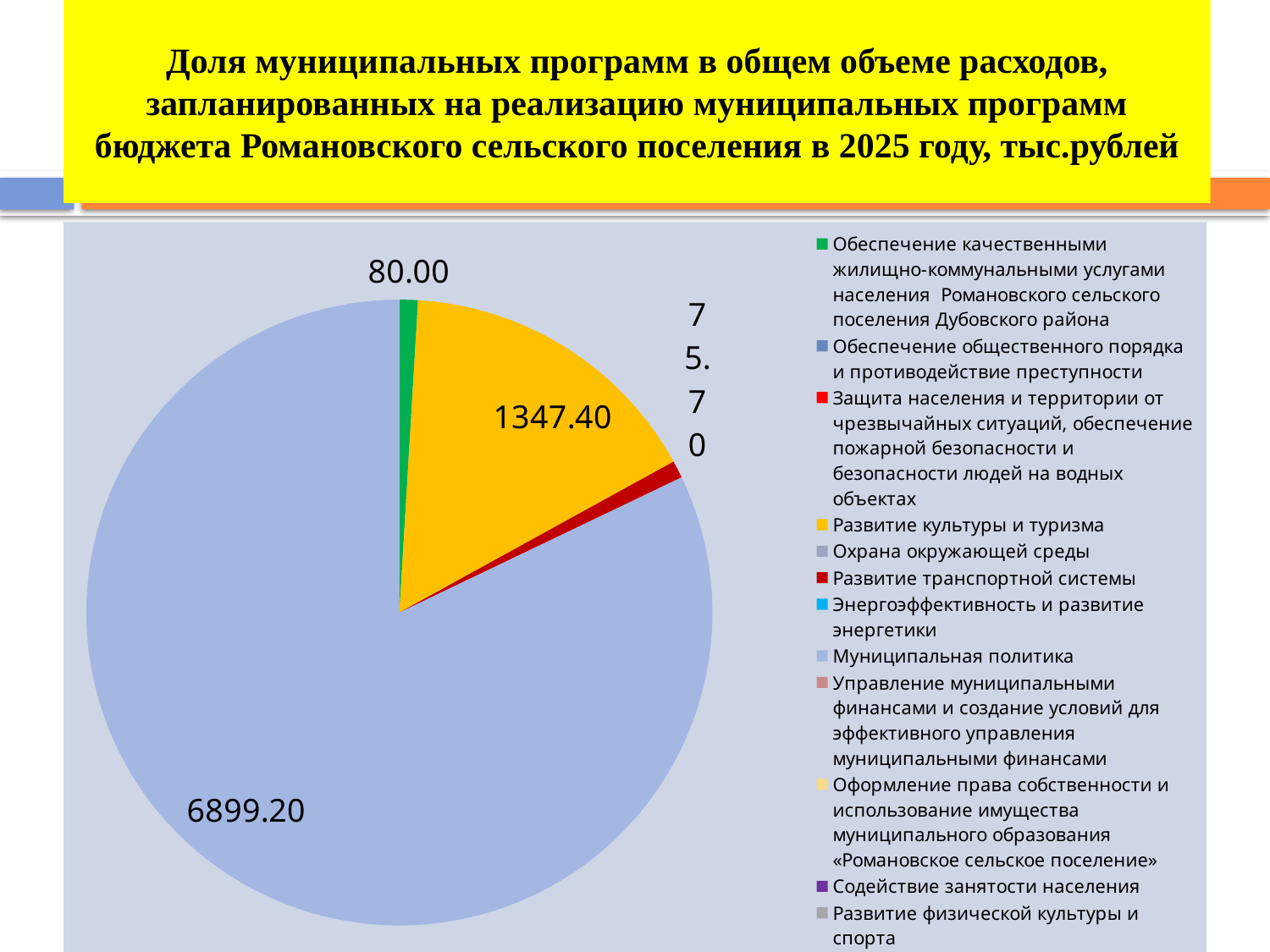
How many entries does the legend list? 12 What is the value shown on the largest slice of the pie? 6899.20 What is the value shown on the dark red slice (Развитие транспортной системы)? 75.70 What colour is the slice for Развитие культуры и туризма? yellow How many slices with data labels are visible in the pie? 4 What is the value for Развитие культуры и туризма? 1347.40 What unit is stated in the chart title for the values? тыс.рублей What kind of chart is shown on the slide? pie chart Which is larger: the value for Развитие культуры и туризма or the value for Обеспечение качественными жилищно-коммунальными услугами? Развитие культуры и туризма What is the difference between the value for Развитие культуры и туризма (1347.40) and the value for Обеспечение качественными жилищно-коммунальными услугами (80.00)? 1267.40 What is the difference between the largest slice (6899.20) and the slice for Развитие культуры и туризма (1347.40)? 5551.80 What is the value for Обеспечение качественными жилищно-коммунальными услугами населения Романовского сельского поселения Дубовского района? 80.00